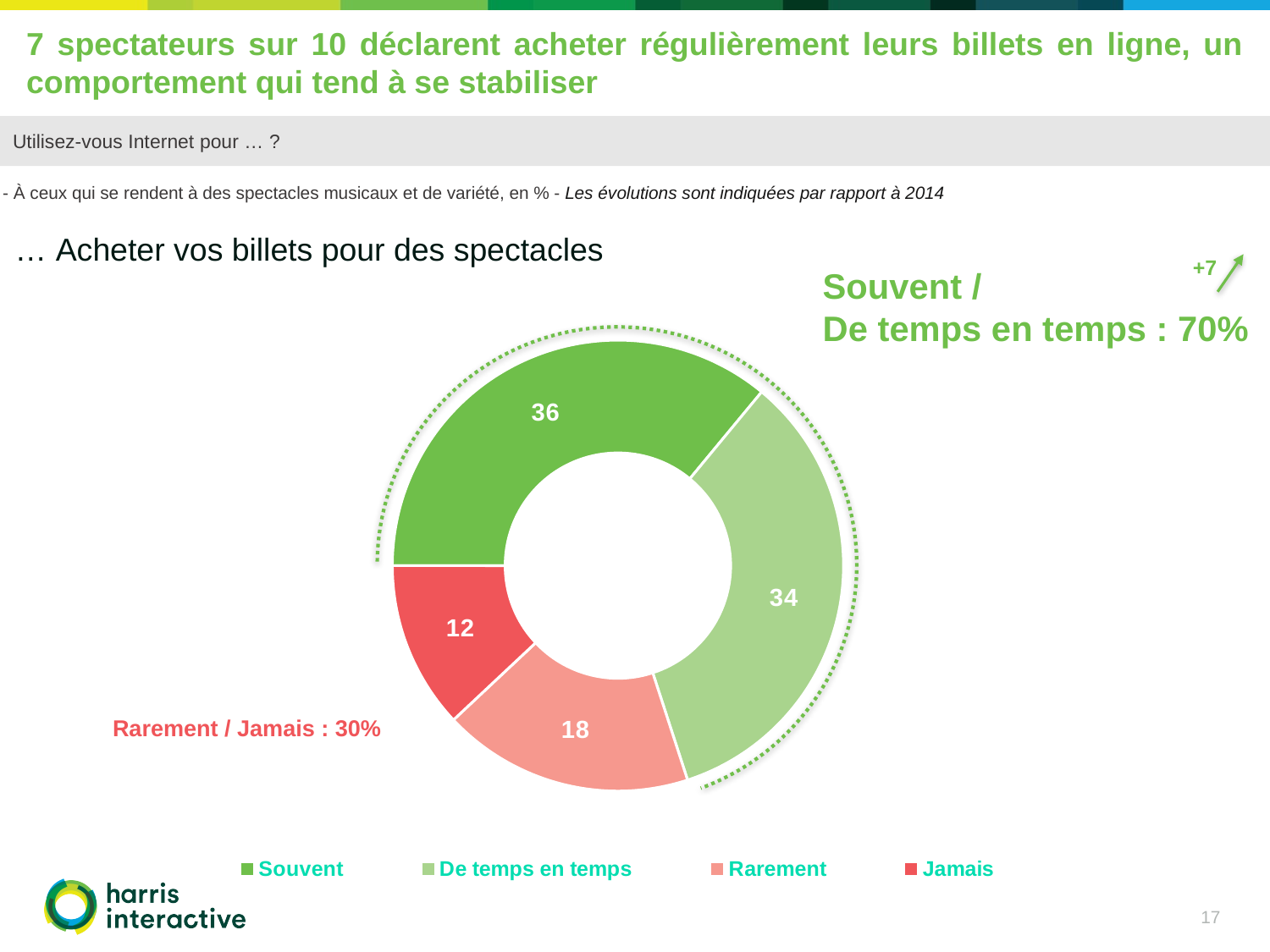
Which is larger, the value for "Souvent" or the value for "Rarement"? Souvent What is the value for "Rarement" in the chart? 18 What is the value for "De temps en temps" in the chart? 34 What change compared to 2014 is indicated next to the "Souvent / De temps en temps" annotation? +7 How many categories does the legend of the chart list? 4 Which category has the smallest slice in the chart? Jamais What is the value for "Jamais" in the chart? 12 What is the difference between the values for "Rarement" and "Jamais"? 6 What type of chart is shown on the slide? Pie chart (donut) Which category has the largest slice in the chart? Souvent According to the annotation on the slide, what is the combined share of "Souvent" and "De temps en temps"? 70% What is the value for "Souvent" in the chart? 36